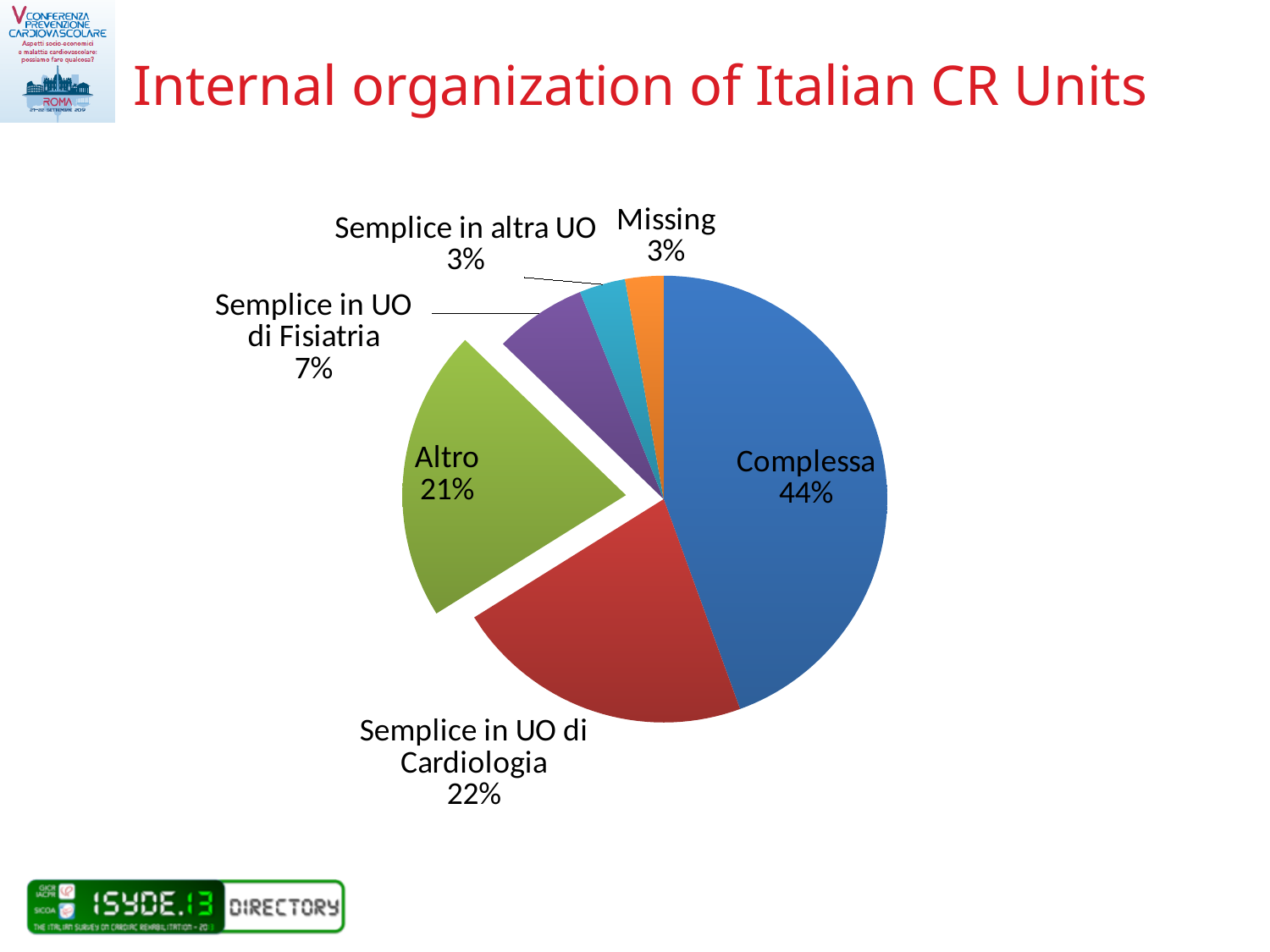
What percentage is shown for Missing? 3% What share of the pie does Complessa represent? 44% Which slice is pulled out (exploded) from the rest of the pie? Altro How many slices does the pie chart have? 6 What percentage is shown for Semplice in UO di Fisiatria? 7% What is the title of the slide containing the pie chart? Internal organization of Italian CR Units What percentage is shown for Semplice in UO di Cardiologia? 22% What percentage is shown for Altro? 21% What type of chart is shown on the slide? pie chart What is the difference in percentage points between Complessa and Semplice in UO di Cardiologia? 22 Which is larger, the share for Altro or the share for Semplice in UO di Fisiatria? Altro Which category has the largest slice of the pie? Complessa